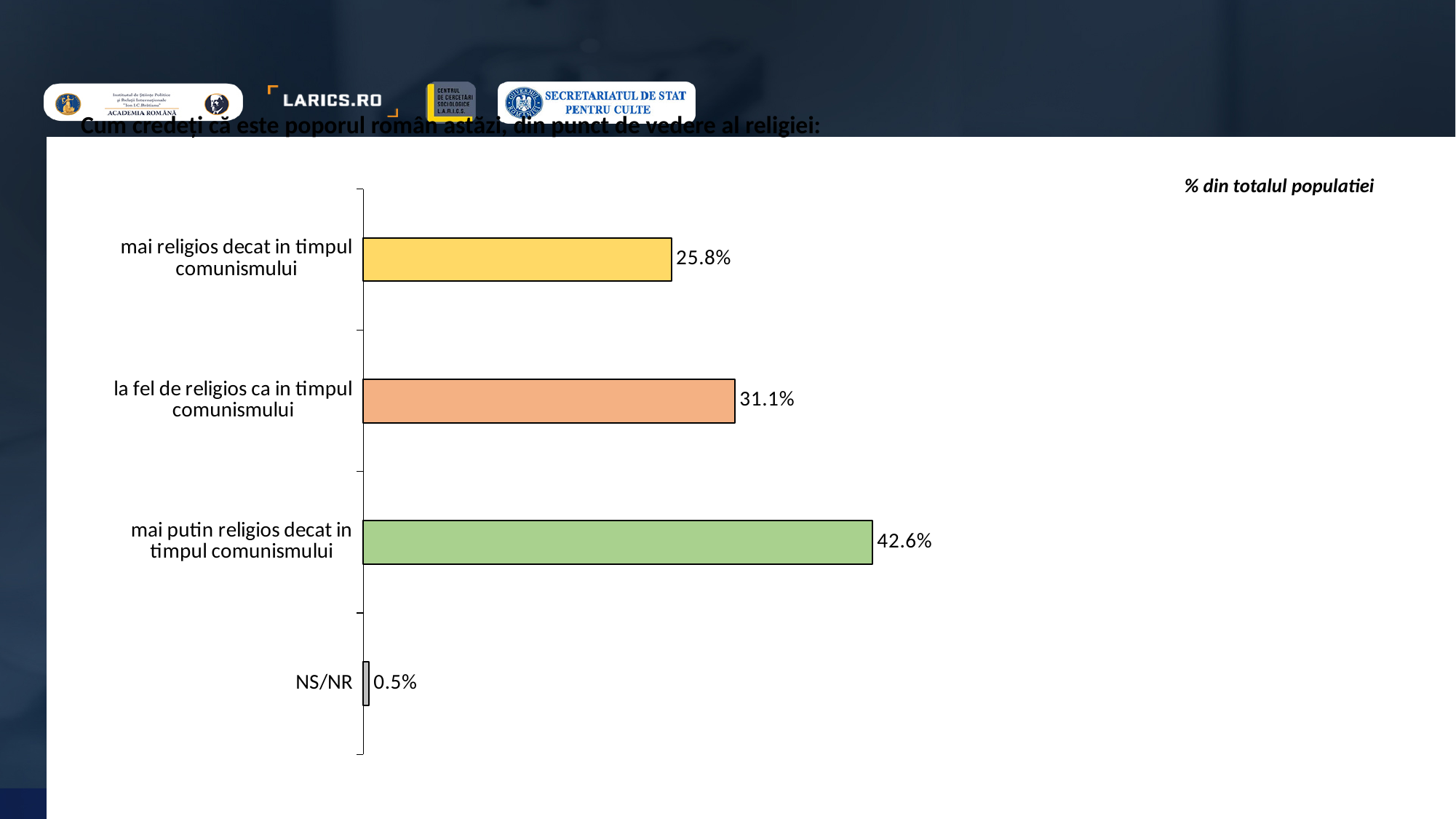
What is the difference between "mai putin religios decat in timpul comunismului" and "mai religios decat in timpul comunismului"? 16.8% Which category has the highest value? mai putin religios decat in timpul comunismului How many categories are shown in the chart? 4 What is the value for "la fel de religios ca in timpul comunismului"? 31.1% What unit note is shown at the top right of the chart? % din totalul populatiei Which is larger: "la fel de religios ca in timpul comunismului" or "mai religios decat in timpul comunismului"? la fel de religios ca in timpul comunismului What kind of chart is shown on the slide? bar chart What is the difference between "la fel de religios ca in timpul comunismului" and "mai religios decat in timpul comunismului"? 5.3% Which category has the lowest value? NS/NR What is the value for NS/NR? 0.5% What is the value for "mai religios decat in timpul comunismului"? 25.8% What is the value for "mai putin religios decat in timpul comunismului"? 42.6%